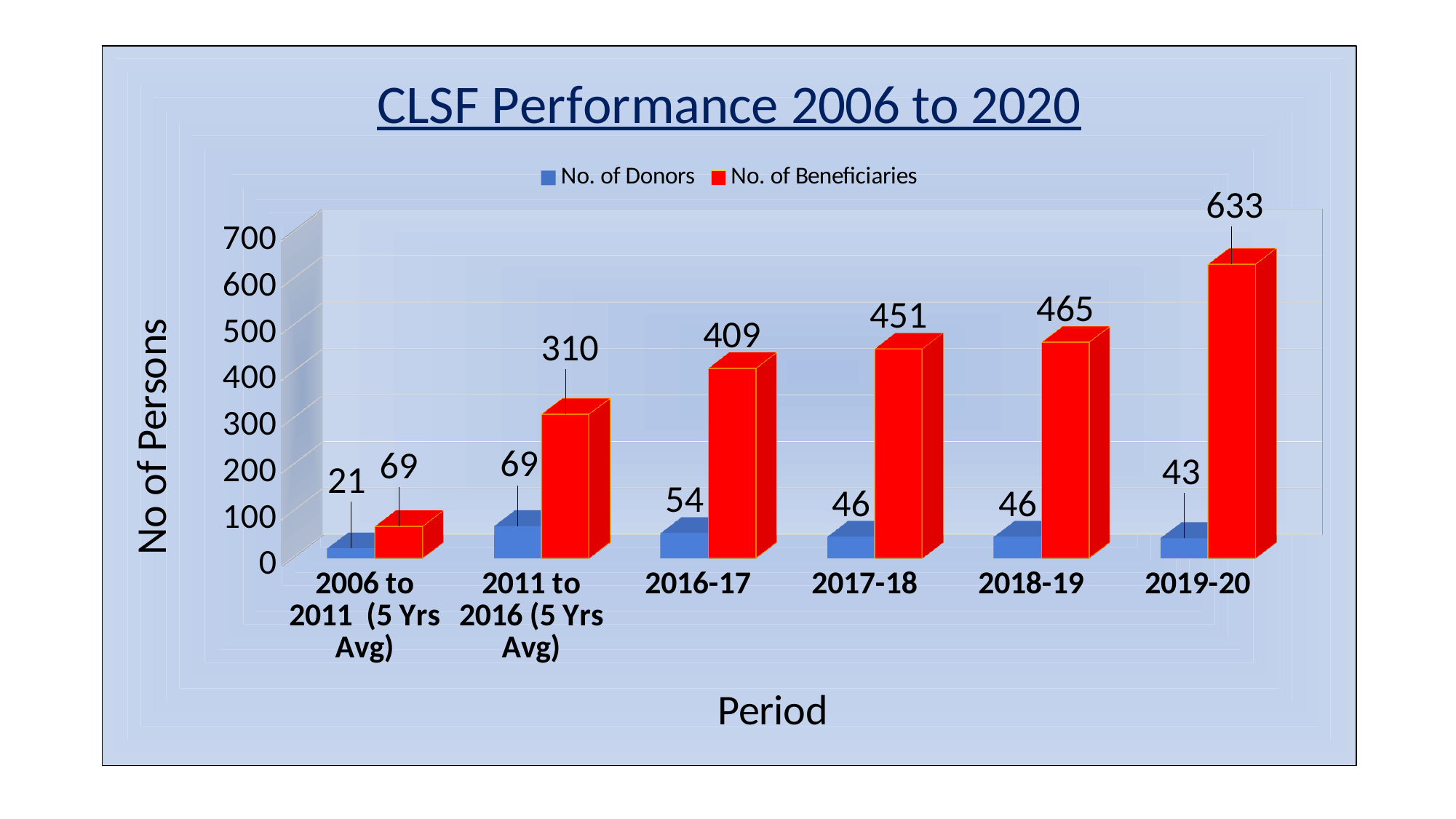
Which period has the lowest number of donors? 2006 to 2011 (5 Yrs Avg) How many series does the legend list? 2 Which period has the highest number of beneficiaries? 2019-20 How many periods are shown on the x axis? 6 What is the difference between the number of beneficiaries in 2019-20 and in 2018-19? 168 What is the title of the chart? CLSF Performance 2006 to 2020 Is the number of beneficiaries for 2017-18 greater or less than 400? greater Which is larger, the number of donors in 2016-17 or in 2019-20? 2016-17 What kind of chart is shown on the slide? bar chart What is the number of beneficiaries for 2019-20? 633 What is the number of beneficiaries for the 2011 to 2016 (5 Yrs Avg) period? 310 What is the number of donors for 2016-17? 54